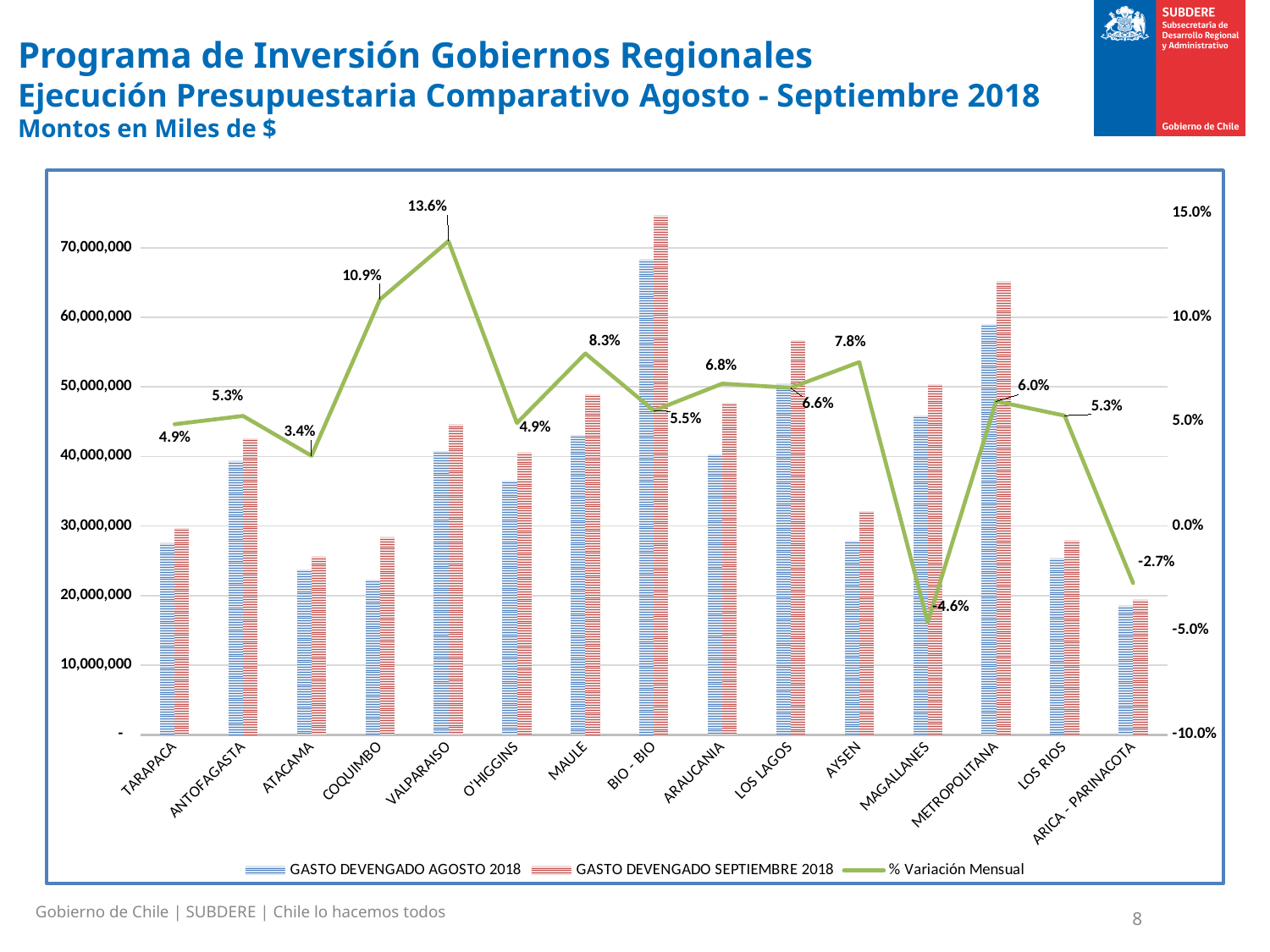
What is the % Variación Mensual for MAGALLANES? -4.6% Which has a higher % Variación Mensual, MAULE or AYSEN? MAULE Is the GASTO DEVENGADO AGOSTO 2018 value for COQUIMBO greater or less than 30,000,000? less How many regions are shown on the x axis? 15 Which region has the highest GASTO DEVENGADO SEPTIEMBRE 2018 bar? BIO - BIO How many series does the legend list? 3 What is the difference in % Variación Mensual between VALPARAISO and COQUIMBO? 2.7 percentage points What is the % Variación Mensual for ARICA - PARINACOTA? -2.7% Which region has the highest % Variación Mensual? VALPARAISO What is the % Variación Mensual for VALPARAISO? 13.6% Which region has the lowest % Variación Mensual? MAGALLANES Is the GASTO DEVENGADO SEPTIEMBRE 2018 value for BIO - BIO greater or less than 70,000,000? greater